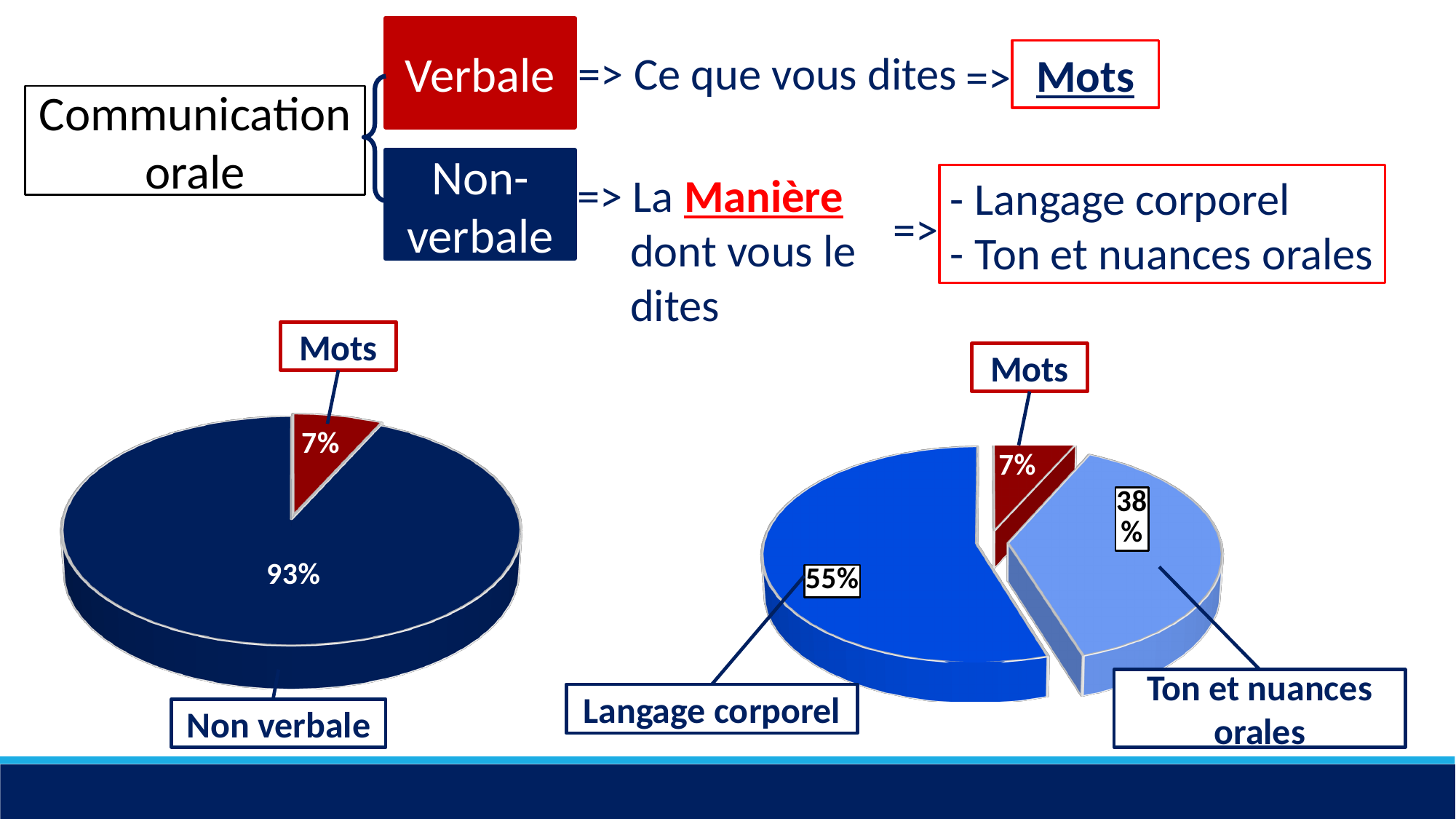
In the left pie chart, what percentage is shown for Mots? 7% In the right pie chart, what percentage is shown for Langage corporel? 55% In the right pie chart, what percentage is shown for Ton et nuances orales? 38% In the left pie chart, what is the difference in percentage points between Non verbale and Mots? 86 How many slices does the right pie chart have? 3 In the left pie chart, what percentage is shown for Non verbale? 93% In the right pie chart, which is larger, Ton et nuances orales or Mots? Ton et nuances orales What type of chart is the left chart? Pie chart In the right pie chart, what percentage is shown for Mots? 7% In the right pie chart, which slice is the smallest? Mots In the right pie chart, what is the difference in percentage points between Langage corporel and Ton et nuances orales? 17 In the right pie chart, which slice is the largest? Langage corporel